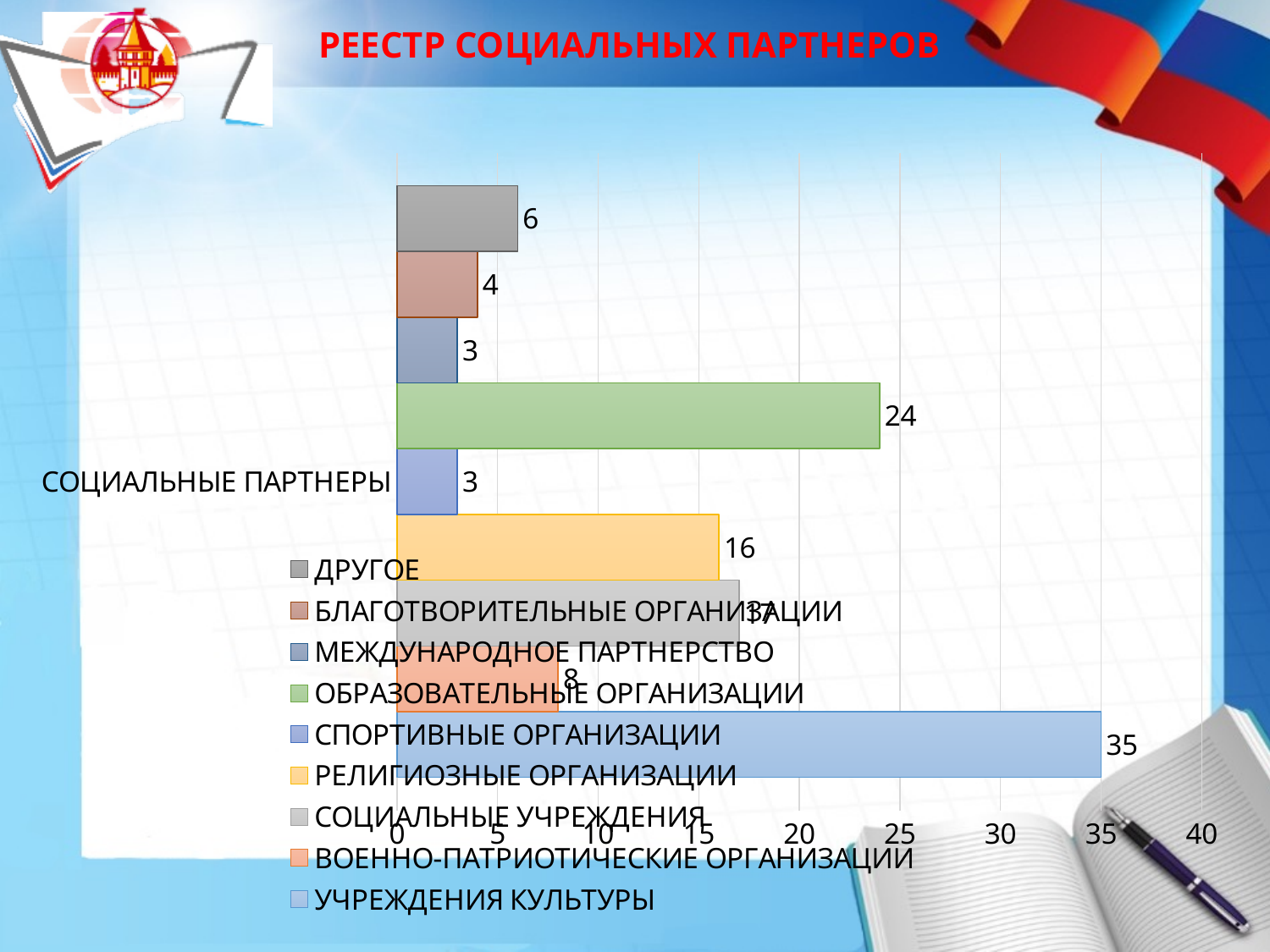
How many series does the legend list? 9 What is the difference between the values for УЧРЕЖДЕНИЯ КУЛЬТУРЫ and ОБРАЗОВАТЕЛЬНЫЕ ОРГАНИЗАЦИИ? 11 What is the value for БЛАГОТВОРИТЕЛЬНЫЕ ОРГАНИЗАЦИИ? 4 What is the value for РЕЛИГИОЗНЫЕ ОРГАНИЗАЦИИ? 16 What is the value for ДРУГОЕ? 6 What is the value for ОБРАЗОВАТЕЛЬНЫЕ ОРГАНИЗАЦИИ? 24 Which is larger, the value for ОБРАЗОВАТЕЛЬНЫЕ ОРГАНИЗАЦИИ or the value for РЕЛИГИОЗНЫЕ ОРГАНИЗАЦИИ? ОБРАЗОВАТЕЛЬНЫЕ ОРГАНИЗАЦИИ What is the title of the slide containing the chart? РЕЕСТР СОЦИАЛЬНЫХ ПАРТНЕРОВ Is the value for СОЦИАЛЬНЫЕ УЧРЕЖДЕНИЯ greater or less than 10? greater Which series has the highest value? УЧРЕЖДЕНИЯ КУЛЬТУРЫ What kind of chart is shown on the slide? bar chart What is the value for УЧРЕЖДЕНИЯ КУЛЬТУРЫ? 35